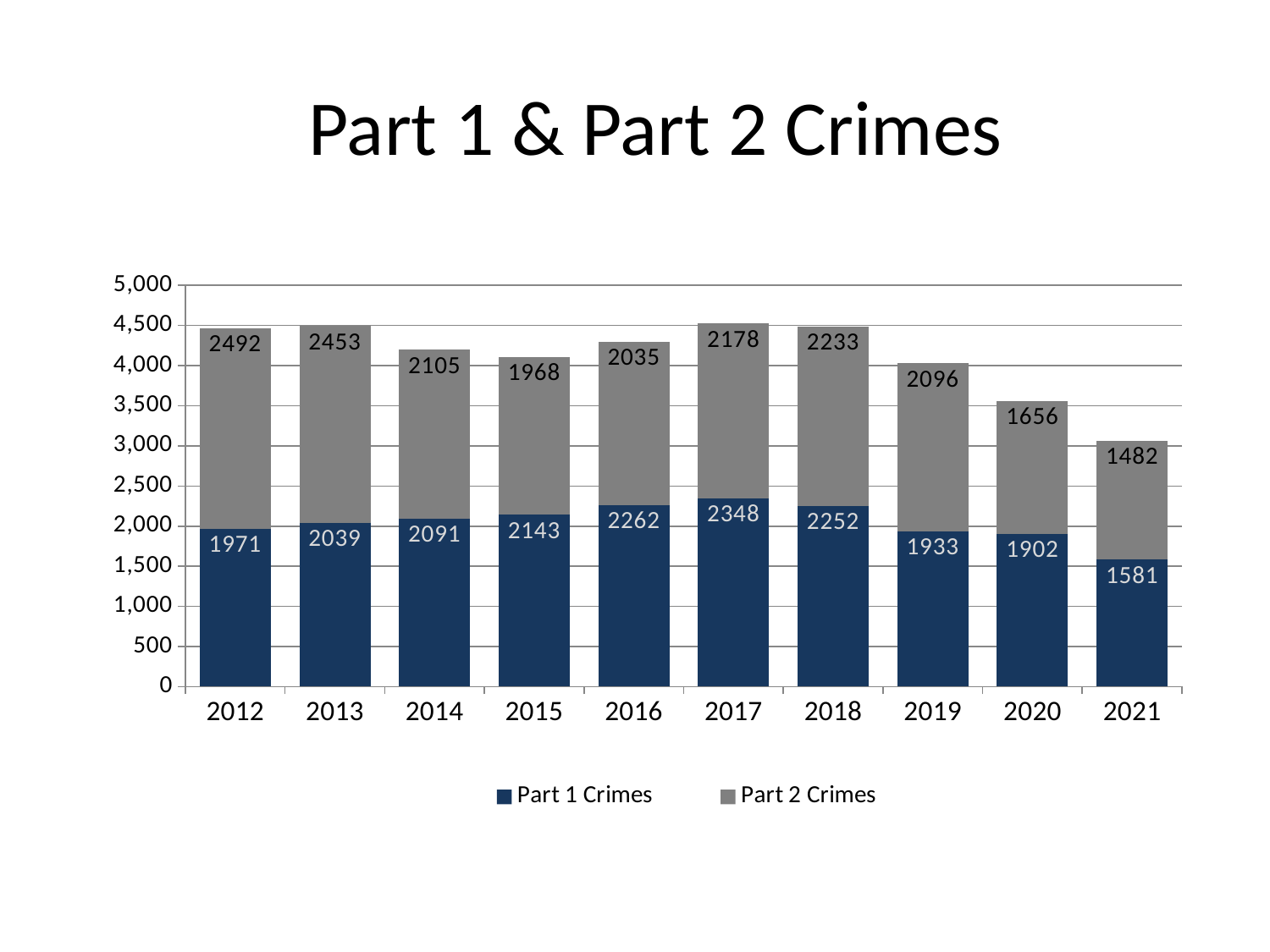
Does the total height of the stacked bars rise or fall from 2018 to 2021? Fall Which year has the lowest value for Part 1 Crimes? 2021 What is the total of the stacked bar for 2012? 4463 What is the value for Part 2 Crimes in 2021? 1482 What is the value for Part 1 Crimes in 2017? 2348 Which is larger: Part 1 Crimes in 2016 or Part 1 Crimes in 2019? Part 1 Crimes in 2016 How many years are shown on the x axis? 10 Which year has the highest value for Part 2 Crimes? 2012 What kind of chart is shown on the slide? Stacked bar chart How many series does the legend list? 2 What is the difference between Part 2 Crimes in 2012 and Part 2 Crimes in 2021? 1010 What is the total of the stacked bar for 2021? 3063